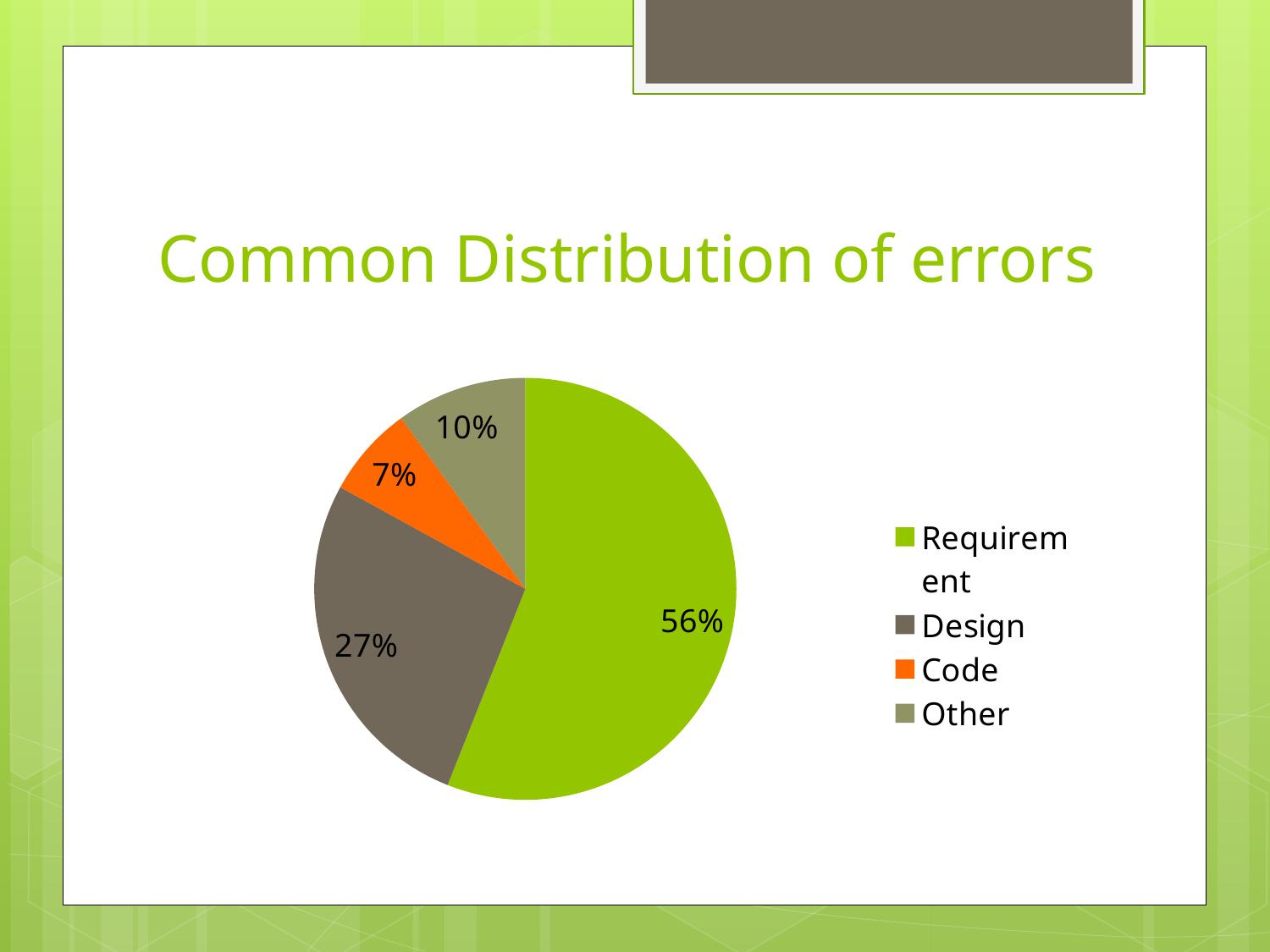
Which category has the smallest share of errors? Code What share of errors is attributed to Requirement? 56% Which category has the largest share of errors? Requirement How many categories does the pie chart show? 4 Which category is shown in orange in the pie chart? Code What kind of chart is shown on the slide? pie chart What share of errors is attributed to Other? 10% What share of errors is attributed to Design? 27% What share of errors is attributed to Code? 7% Which has a larger share of errors, Other or Code? Other What is the difference in percentage points between the Requirement and Design shares? 29 What is the title of the slide containing the chart? Common Distribution of errors